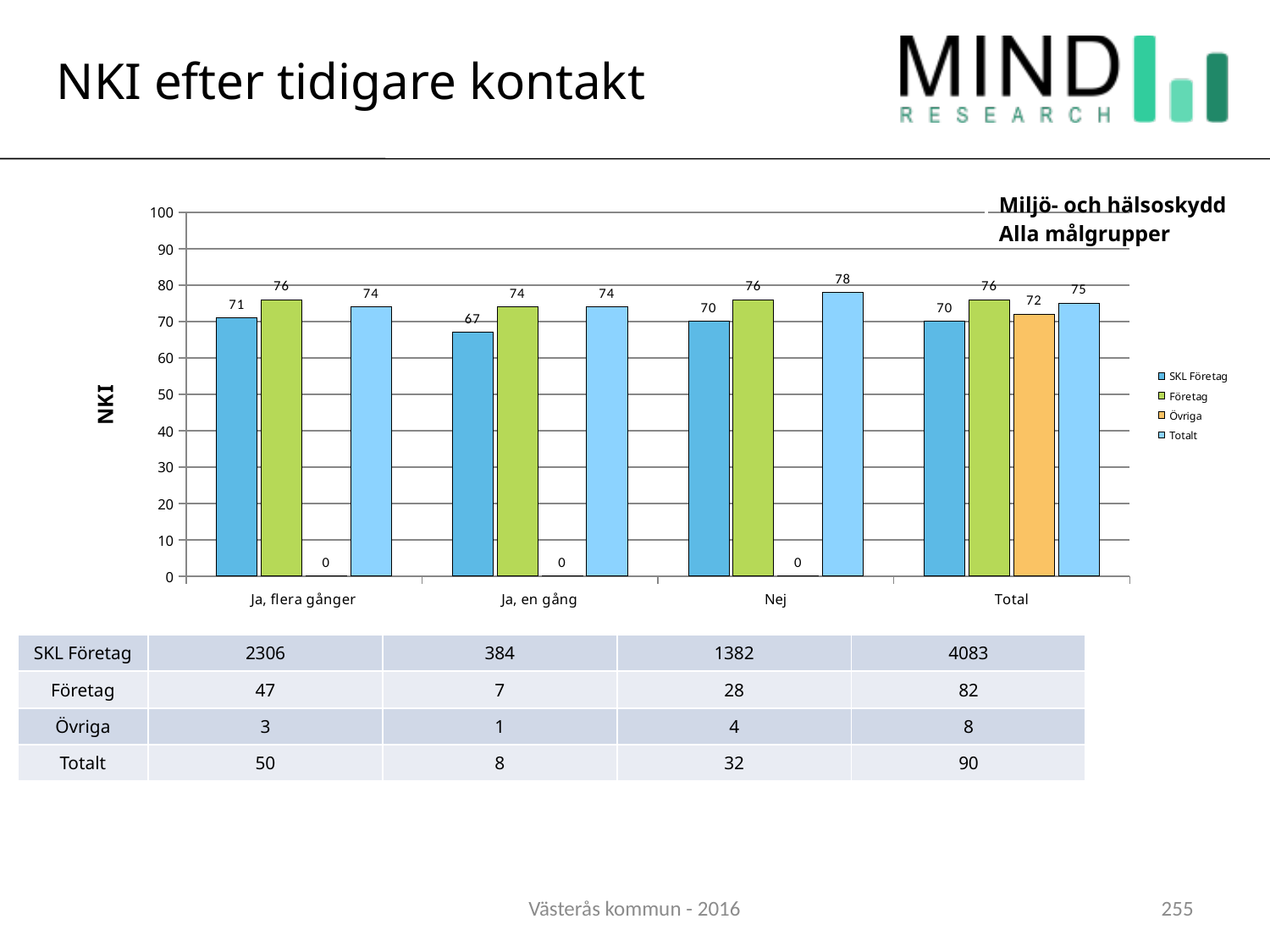
What is the NKI value for Företag in the 'Ja, en gång' category? 74 Which category has the lowest NKI value for SKL Företag? Ja, en gång What kind of chart is shown on the slide? Bar chart What is the NKI value for SKL Företag in the 'Ja, flera gånger' category? 71 How many series does the chart legend list? 4 Which is larger in the 'Total' category: the Företag value or the Övriga value? Företag What is the label on the vertical axis of the chart? NKI What is the NKI value for Övriga in the 'Total' category? 72 Which category has the highest NKI value for Totalt? Nej What is the difference between the Företag and SKL Företag values in the 'Ja, en gång' category? 7 How many categories are shown on the x axis of the chart? 4 What is the NKI value for Totalt in the 'Nej' category? 78